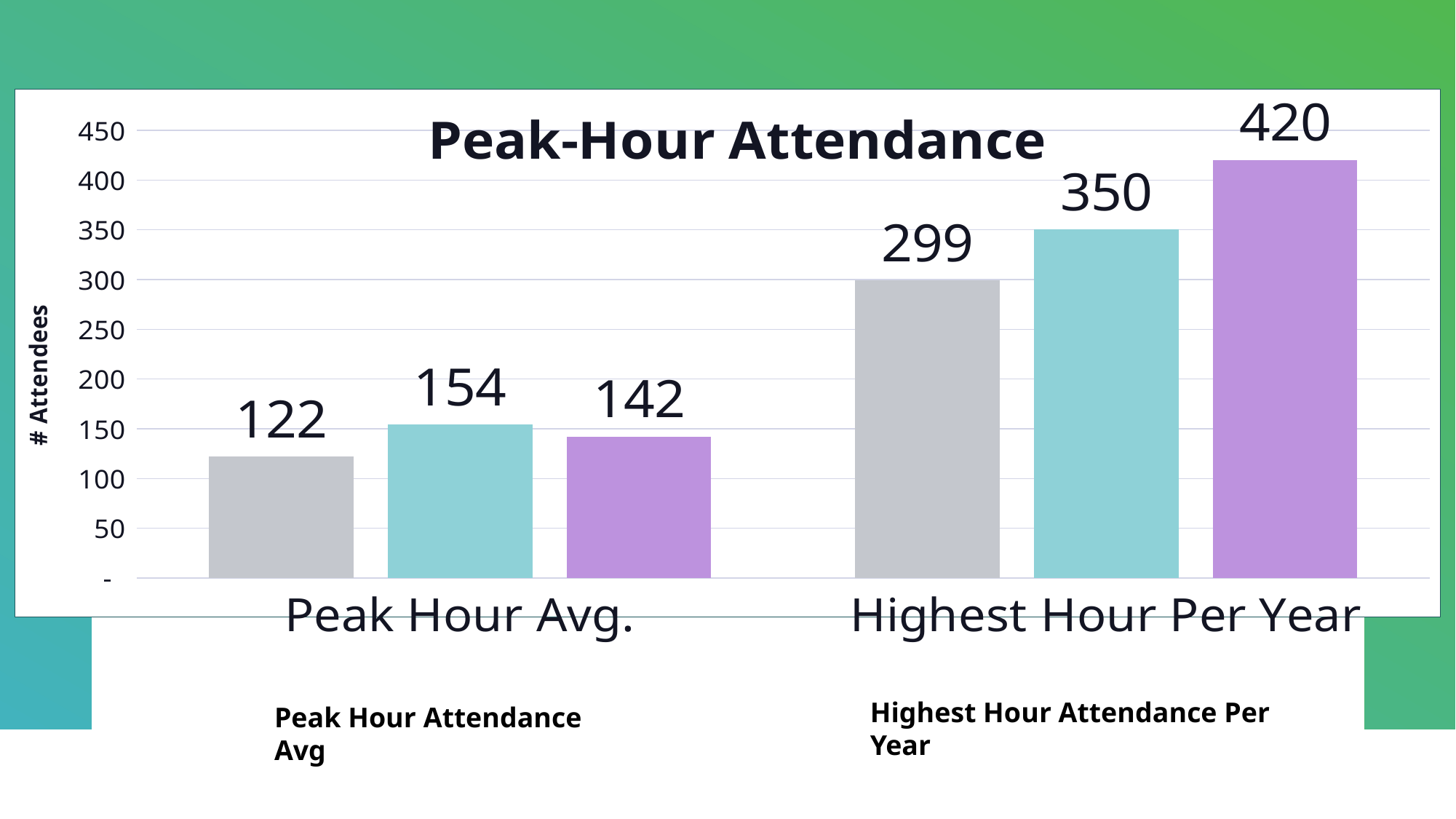
What is the value of the grey bar in the Peak Hour Avg. group? 122 Which bar has the highest value on the chart? The purple bar in Highest Hour Per Year (420) What is the difference between the teal bar and the grey bar in the Peak Hour Avg. group? 32 What is the title of the chart? Peak-Hour Attendance Is the value of the teal bar in the Highest Hour Per Year group greater or less than 300? greater What is the value of the purple bar in the Highest Hour Per Year group? 420 How many category groups are shown on the x axis? 2 Which bar has the lowest value on the chart? The grey bar in Peak Hour Avg. (122) In the Peak Hour Avg. group, which is larger, the teal bar or the purple bar? The teal bar What is the value of the grey bar in the Highest Hour Per Year group? 299 What is the difference between the purple bar and the teal bar in the Highest Hour Per Year group? 70 What is the value of the teal bar in the Peak Hour Avg. group? 154